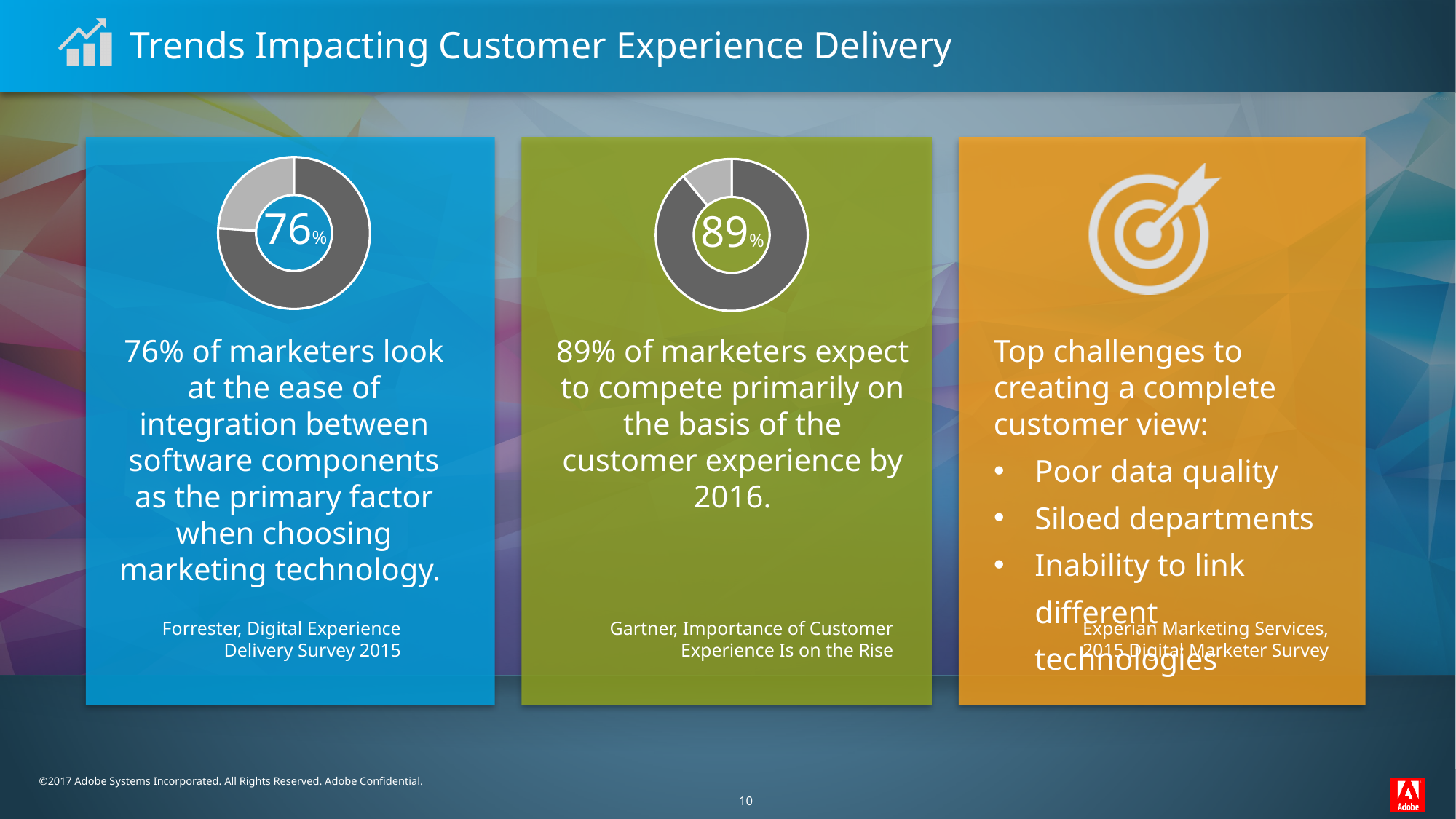
How many donut charts are shown on the slide? 2 What source is cited beneath the donut chart on the middle (green) panel? Gartner, Importance of Customer Experience Is on the Rise Is the value shown in the left (blue) panel's donut chart greater or less than 80%? less Which donut chart shows the larger value, the one on the left (blue) panel or the one on the middle (green) panel? The middle (green) panel What percentage is shown in the centre of the donut chart on the middle (green) panel? 89% What percentage is shown in the centre of the donut chart on the left (blue) panel? 76% What kind of chart is used on the left (blue) panel? Donut chart Is the value shown in the middle (green) panel's donut chart greater or less than 80%? greater What is the difference in percentage points between the value in the middle (green) panel's donut chart and the value in the left (blue) panel's donut chart? 13 percentage points In the middle (green) panel's donut chart, what share of the ring is filled by the dark grey segment? 89% What kind of chart is used on the middle (green) panel? Donut chart In the left (blue) panel's donut chart, what share of the ring is filled by the dark grey segment? 76%